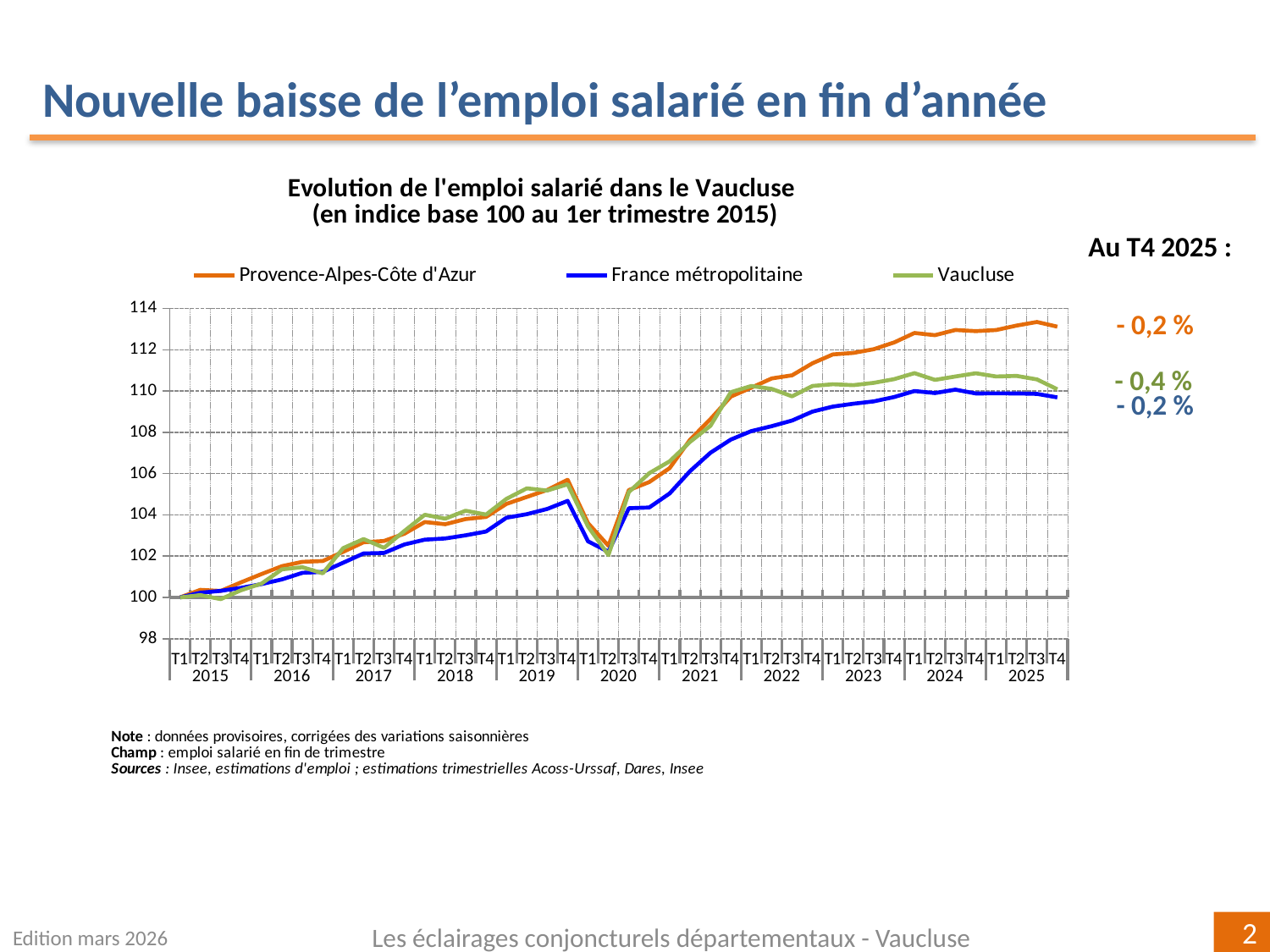
Overall, do the index values rise or fall from 2015 to 2025? rise How many series does the legend list? 3 What kind of chart is shown on the slide? line chart What is the index value of all three series at T1 2015? 100 Is the value for France métropolitaine at T4 2025 greater or less than 112? less Which series has the highest index value at T4 2025? Provence-Alpes-Côte d'Azur What is the title of the chart? Evolution de l'emploi salarié dans le Vaucluse (en indice base 100 au 1er trimestre 2015) Which series is drawn in green? Vaucluse What change is shown for Vaucluse at T4 2025? - 0,4 % What change is shown for Provence-Alpes-Côte d'Azur at T4 2025? - 0,2 % How many years are shown on the x axis? 11 Is the value for Provence-Alpes-Côte d'Azur at T4 2025 greater or less than 112? greater